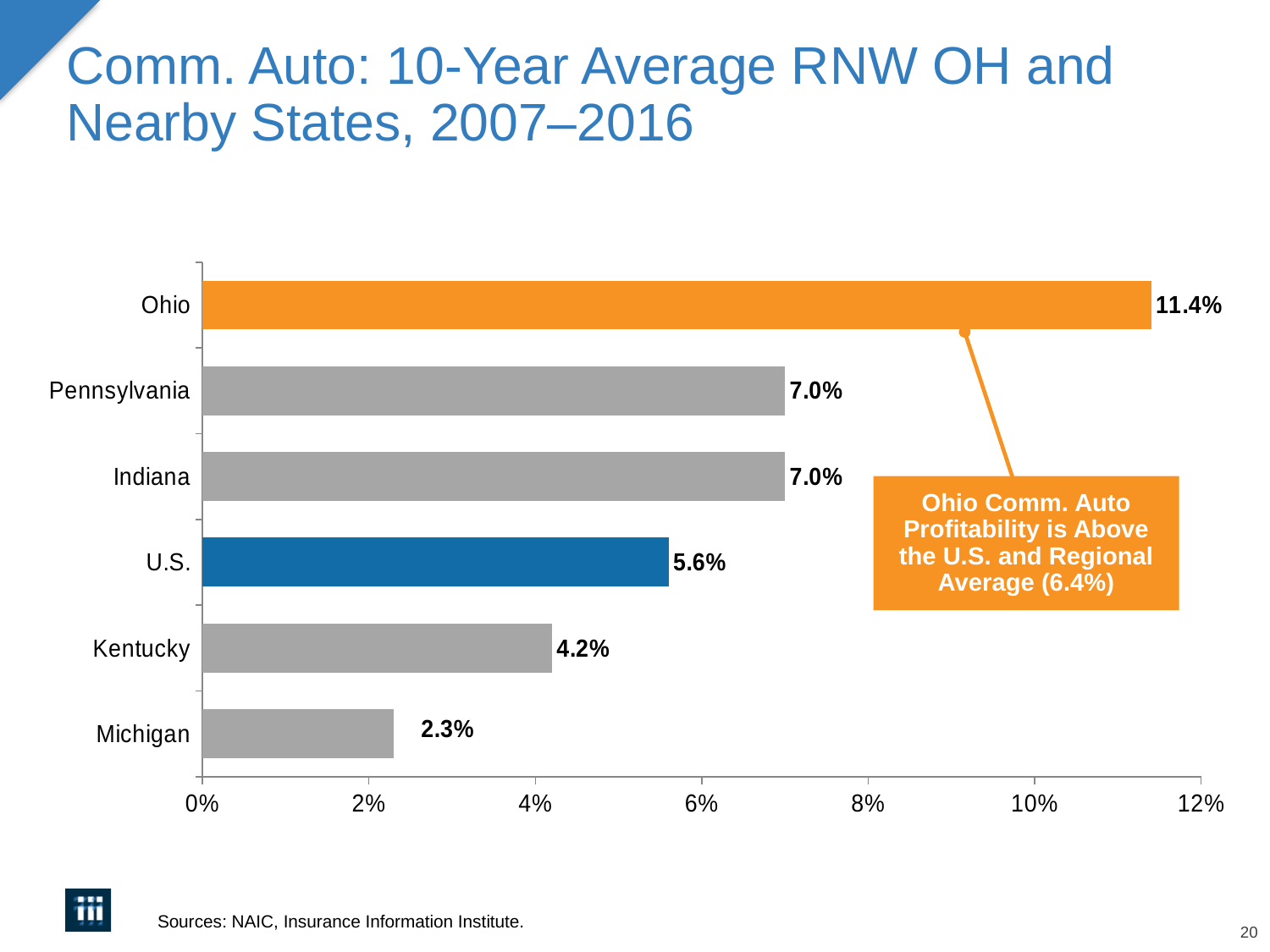
What is the value shown for the U.S.? 5.6% Is the value for Indiana greater or less than 6%? greater How many bars are shown in the chart? 6 Which state has the highest 10-year average RNW? Ohio Which state has the lowest 10-year average RNW? Michigan What is the value shown for Kentucky? 4.2% What is the 10-year average RNW for Ohio? 11.4% What regional average is cited in the callout box on the chart? 6.4% Which is larger, the value for Pennsylvania or the value for Kentucky? Pennsylvania What kind of chart is shown on the slide? Bar chart What is the difference between Ohio's value and the U.S. value? 5.8% What is the difference between Kentucky's value and Michigan's value? 1.9%